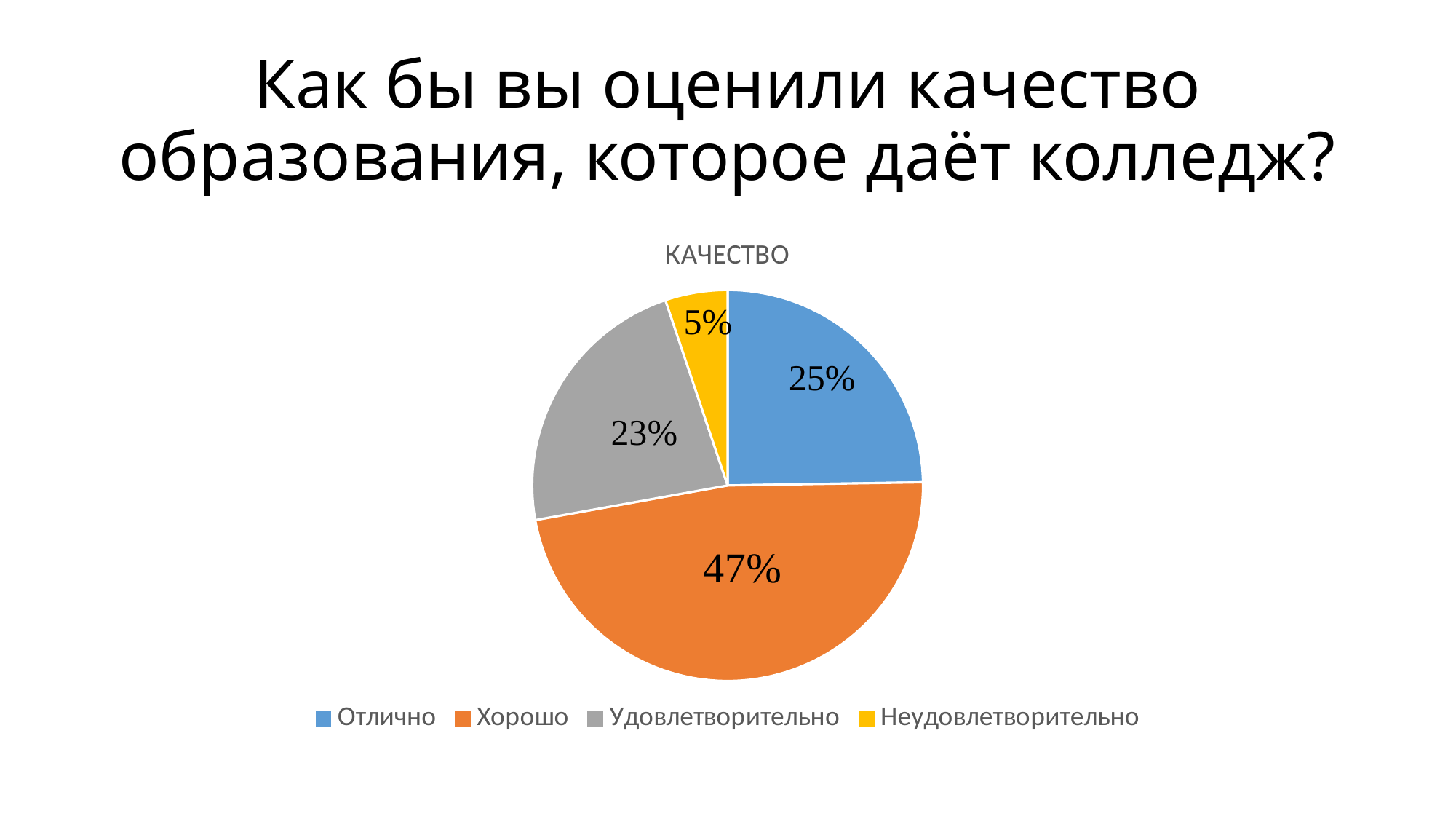
What kind of chart is shown on the slide? Pie chart How many categories does the pie chart show? 4 What share of the pie does Хорошо have? 47% What share of the pie does Отлично have? 25% What is the difference in percentage points between Удовлетворительно and Неудовлетворительно? 18 Which is larger, the share for Отлично or the share for Удовлетворительно? Отлично What is the title of the chart? КАЧЕСТВО What share of the pie does Неудовлетворительно have? 5% Which category has the smallest slice of the pie? Неудовлетворительно Which category has the largest slice of the pie? Хорошо What is the difference in percentage points between Хорошо and Отлично? 22